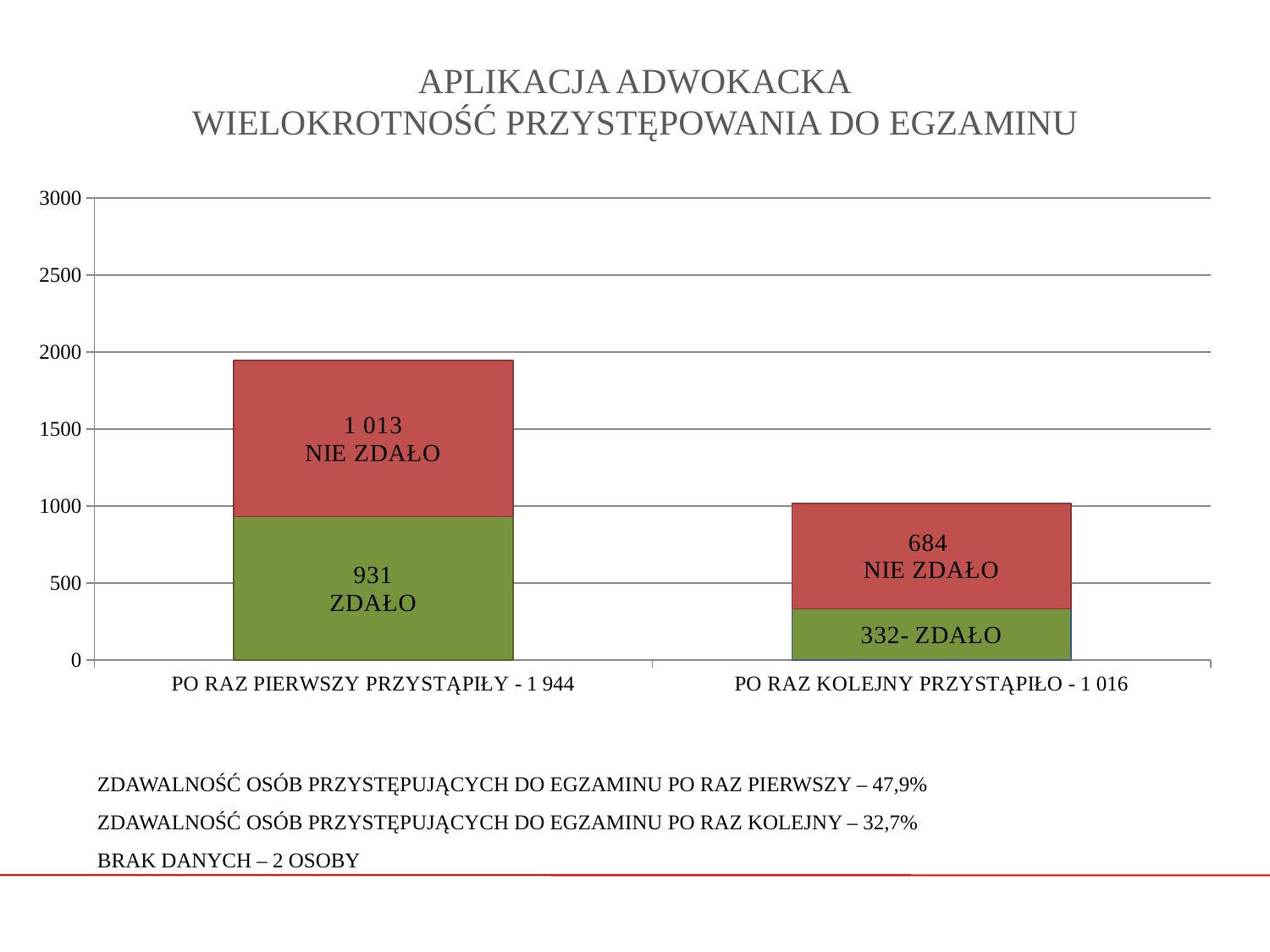
What is the total height of the stacked bar for PO RAZ PIERWSZY PRZYSTĄPIŁY? 1 944 Which category has the taller stacked bar? PO RAZ PIERWSZY PRZYSTĄPIŁY How many people failed (NIE ZDAŁO) among those taking the exam for the first time (PO RAZ PIERWSZY PRZYSTĄPIŁY)? 1 013 How many people passed (ZDAŁO) among those taking the exam for the first time (PO RAZ PIERWSZY PRZYSTĄPIŁY)? 931 How many people failed (NIE ZDAŁO) among those taking the exam again (PO RAZ KOLEJNY PRZYSTĄPIŁO)? 684 What is the total height of the stacked bar for PO RAZ KOLEJNY PRZYSTĄPIŁO? 1 016 Is the total for PO RAZ KOLEJNY PRZYSTĄPIŁO greater or less than 1000? greater How many categories are shown on the x axis? 2 How many people passed (ZDAŁO) among those taking the exam again (PO RAZ KOLEJNY PRZYSTĄPIŁO)? 332 What is the difference between the number who failed and the number who passed among first-time takers (PO RAZ PIERWSZY PRZYSTĄPIŁY)? 82 What kind of chart is shown on the slide? stacked bar chart Which colour represents the people who passed (ZDAŁO) in the chart? green